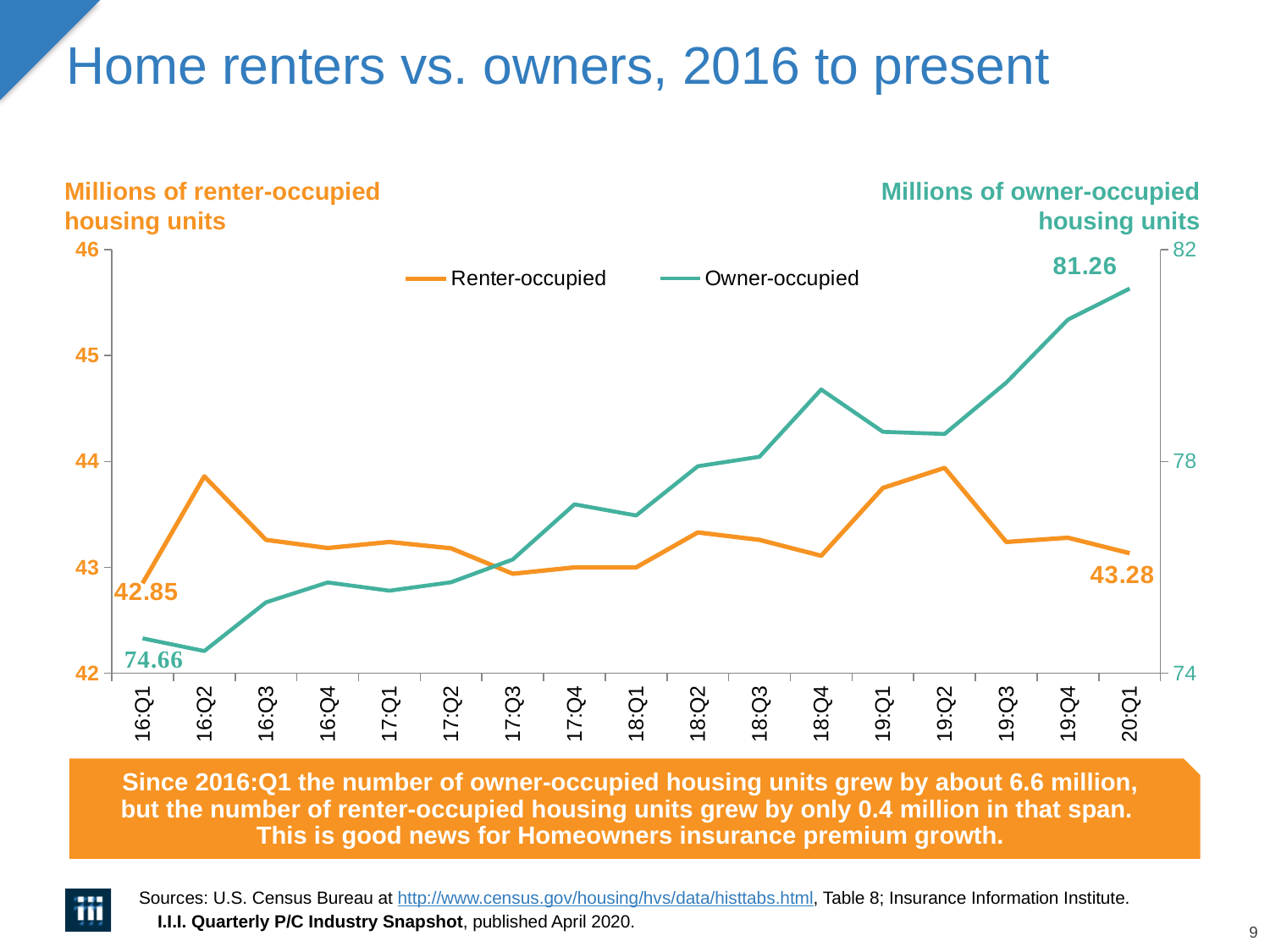
By how much did the Owner-occupied value increase from 16:Q1 to 20:Q1? 6.6 Does the Owner-occupied line generally rise or fall from 16:Q1 to 20:Q1? Rise Is the Owner-occupied value for 18:Q4 greater or less than 78? greater What is the value for Owner-occupied housing units in 20:Q1? 81.26 How many quarters are plotted along the x axis? 17 By how much did the Renter-occupied value increase from 16:Q1 to 20:Q1? 0.43 What is the value for Renter-occupied housing units in 16:Q1? 42.85 In which quarter is the Renter-occupied value lowest? 16:Q1 What is the value for Owner-occupied housing units in 16:Q1? 74.66 What kind of chart is shown on the slide? Line chart What is the value for Renter-occupied housing units in 20:Q1? 43.28 How many series does the legend list? 2